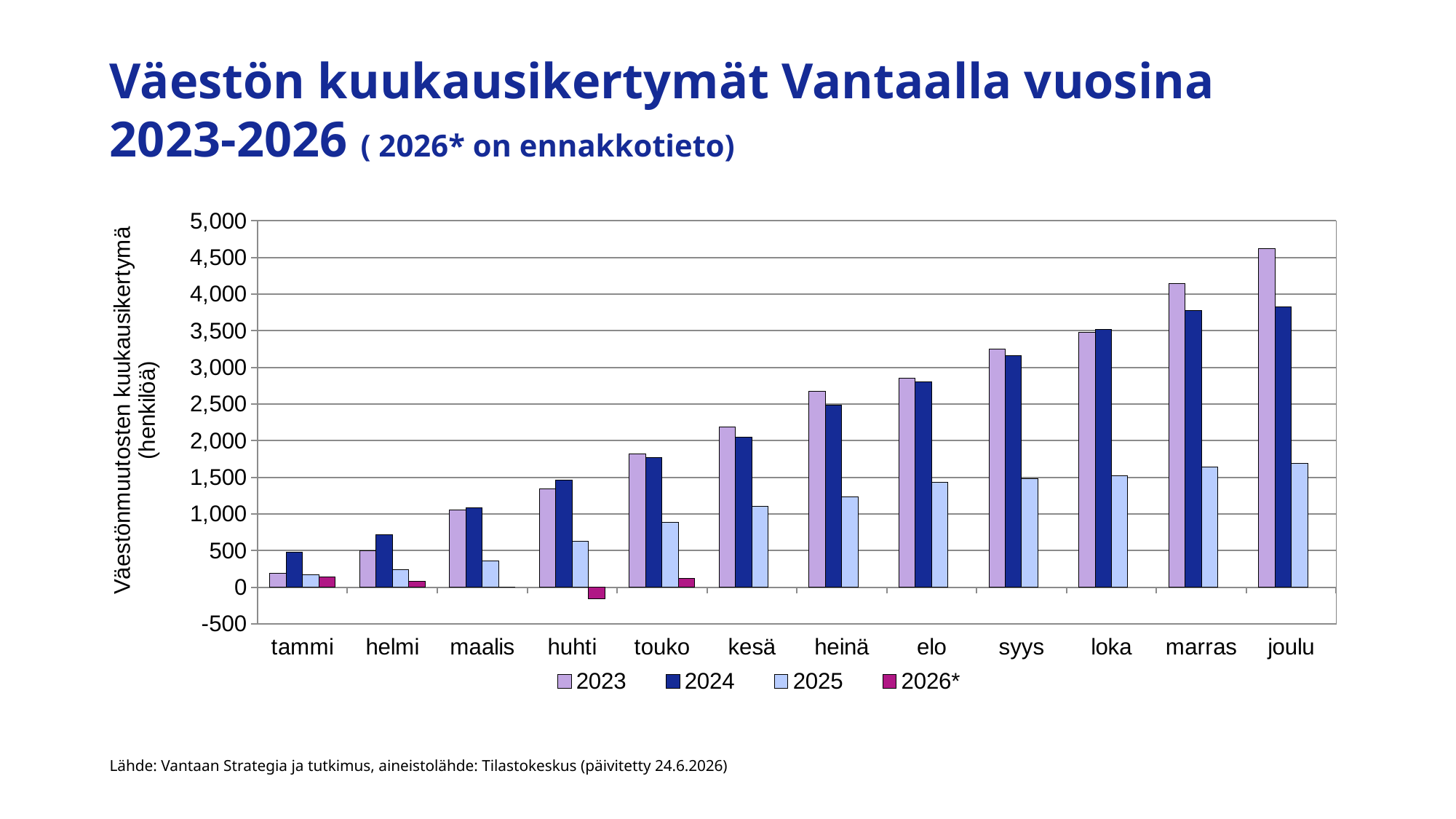
How many months are shown on the x axis? 12 Is the 2024 value for joulu greater or less than 3,500? greater Do the 2025 values rise or fall from tammi to joulu? rise In which month is the 2026* value lowest? huhti For marras, which series has the larger value, 2023 or 2024? 2023 What kind of chart is shown on the slide? bar chart Is the 2025 value for joulu greater or less than 2,000? less For tammi, which series has the larger value, 2023 or 2024? 2024 Is the 2023 value for joulu greater or less than 4,000? greater Which legend entry is marked with an asterisk as preliminary data? 2026* How many series does the legend list? 4 In which month is the 2023 value highest? joulu